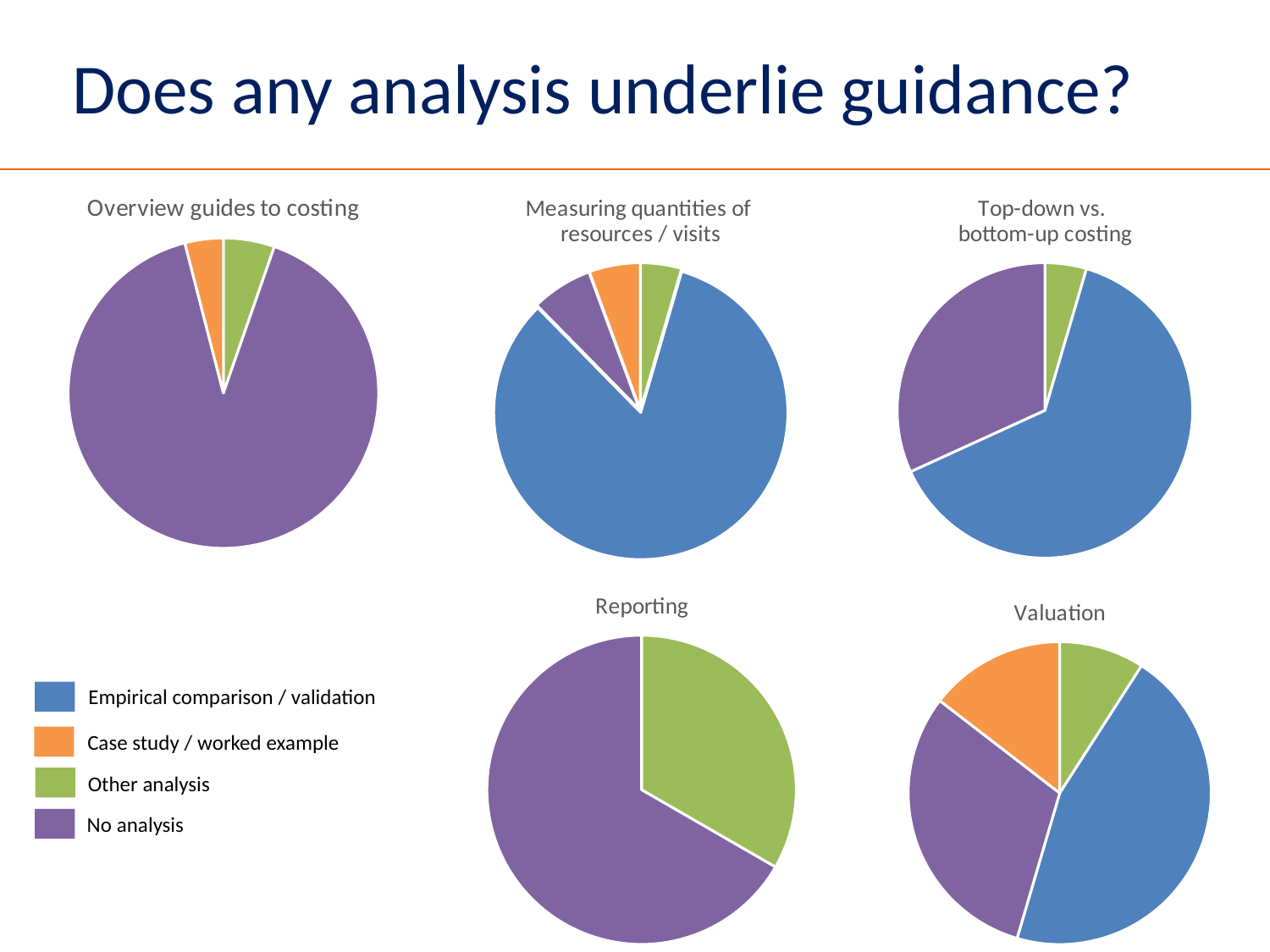
What type of chart is used for 'Reporting'? Pie chart In the 'Top-down vs. bottom-up costing' chart, which category has the largest slice? Empirical comparison / validation How many slices does the 'Reporting' pie chart have? 2 How many slices does the 'Overview guides to costing' pie chart have? 3 In the 'Valuation' chart, which category has the smallest slice? Other analysis In the 'Overview guides to costing' chart, which category has the largest slice? No analysis How many slices does the 'Measuring quantities of resources / visits' pie chart have? 4 How many categories does the legend list? 4 In the 'Reporting' chart, which is larger: No analysis or Other analysis? No analysis In the 'Valuation' chart, which category has the largest slice? Empirical comparison / validation In the 'Top-down vs. bottom-up costing' chart, which category has the smallest slice? Other analysis